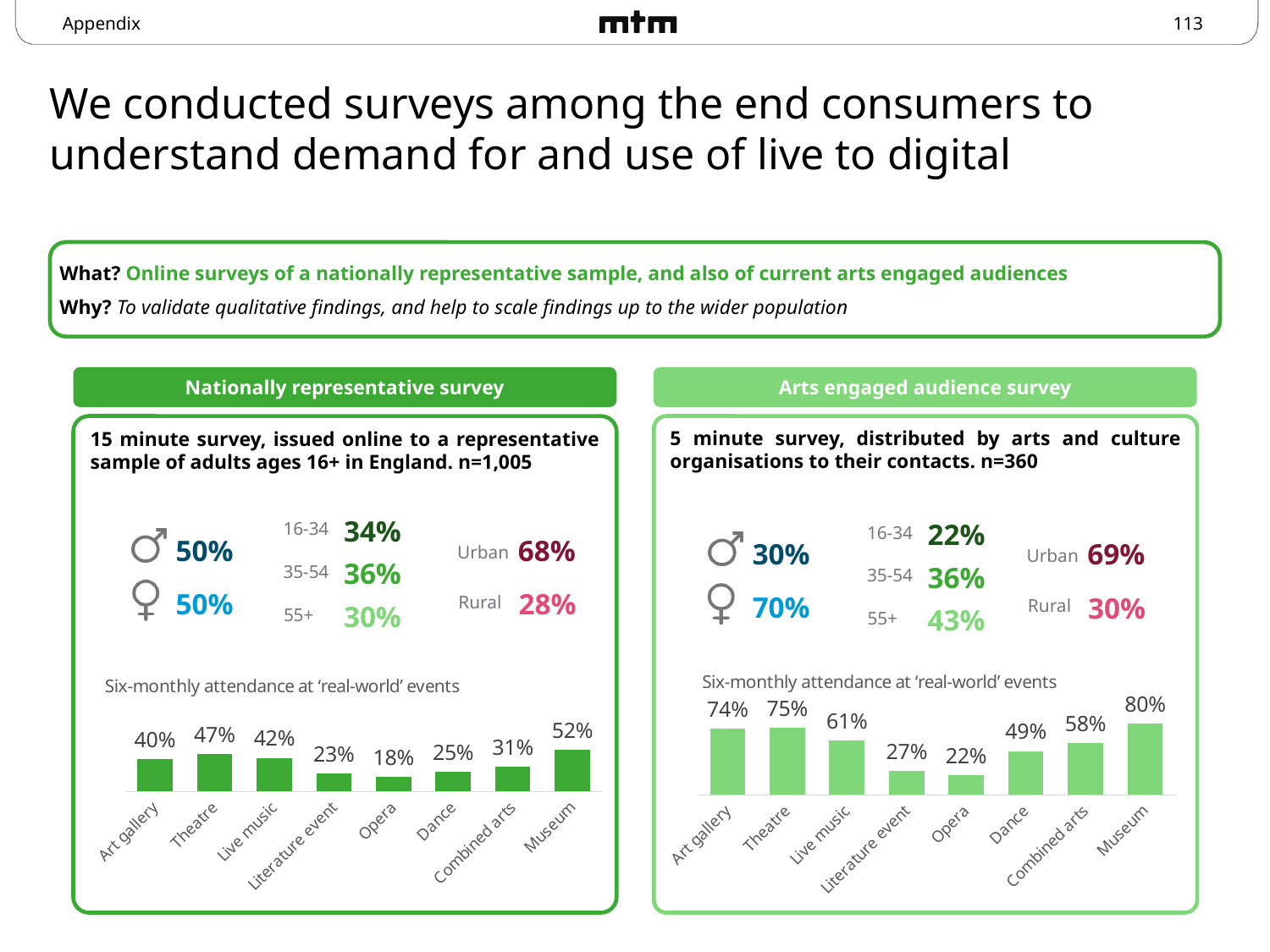
In the Nationally representative survey chart, which is larger: Dance or Combined arts? Combined arts In the Arts engaged audience survey chart, what is the six-monthly attendance value for Dance? 49% In the Arts engaged audience survey chart, which event category has the lowest attendance? Opera How many event categories are shown in the Nationally representative survey attendance chart? 8 In the Arts engaged audience survey chart, what is the attendance value for Art gallery? 74% In the Nationally representative survey chart, what is the six-monthly attendance value for Theatre? 47% In the Nationally representative survey chart, what is the difference between the Museum and Opera values? 34% In the Arts engaged audience survey chart, what is the difference between the Museum and Literature event values? 53% In the Nationally representative survey chart, which event category has the highest attendance? Museum What type of chart is used to show six-monthly attendance in the Arts engaged audience survey panel? Bar chart What is the title of the attendance chart in the Nationally representative survey panel? Six-monthly attendance at 'real-world' events In the Arts engaged audience survey chart, which is larger: Live music or Combined arts? Live music